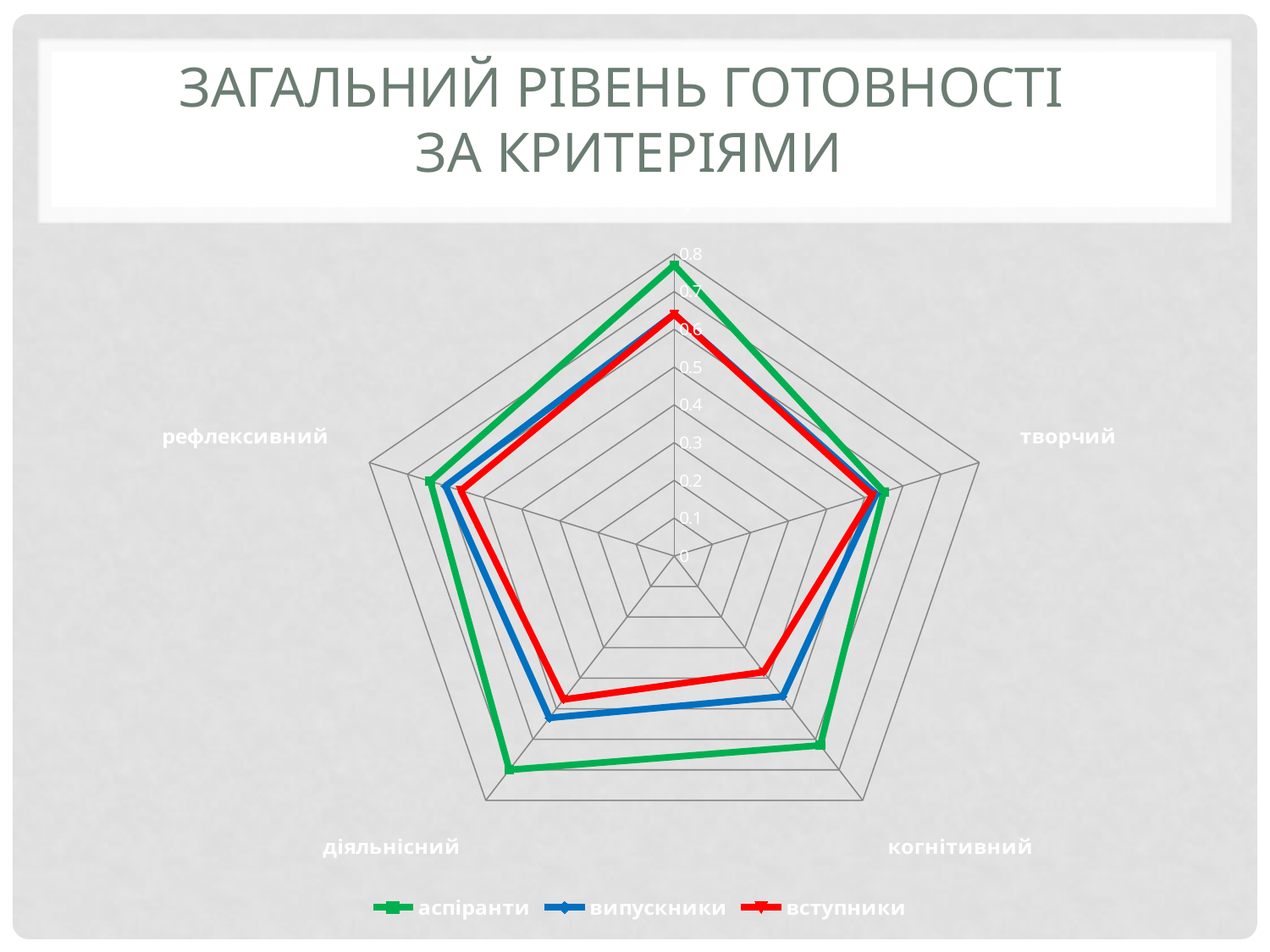
Is the value for вступники on the рефлексивний axis greater or less than 0.4? greater How many series does the legend list? 3 Is the value for аспіранти on the діяльнісний axis greater or less than 0.6? greater Which series has the highest value on the когнітивний axis? аспіранти Which series has the lowest value on the рефлексивний axis? вступники On the когнітивний axis, which series has the larger value: аспіранти or вступники? аспіранти On the діяльнісний axis, which series has the larger value: випускники or вступники? випускники Is the value for вступники on the когнітивний axis greater or less than 0.5? less How many axes (criteria) does the radar chart have? 5 What kind of chart is shown on the slide? radar chart What are the series names listed in the legend? аспіранти, випускники, вступники